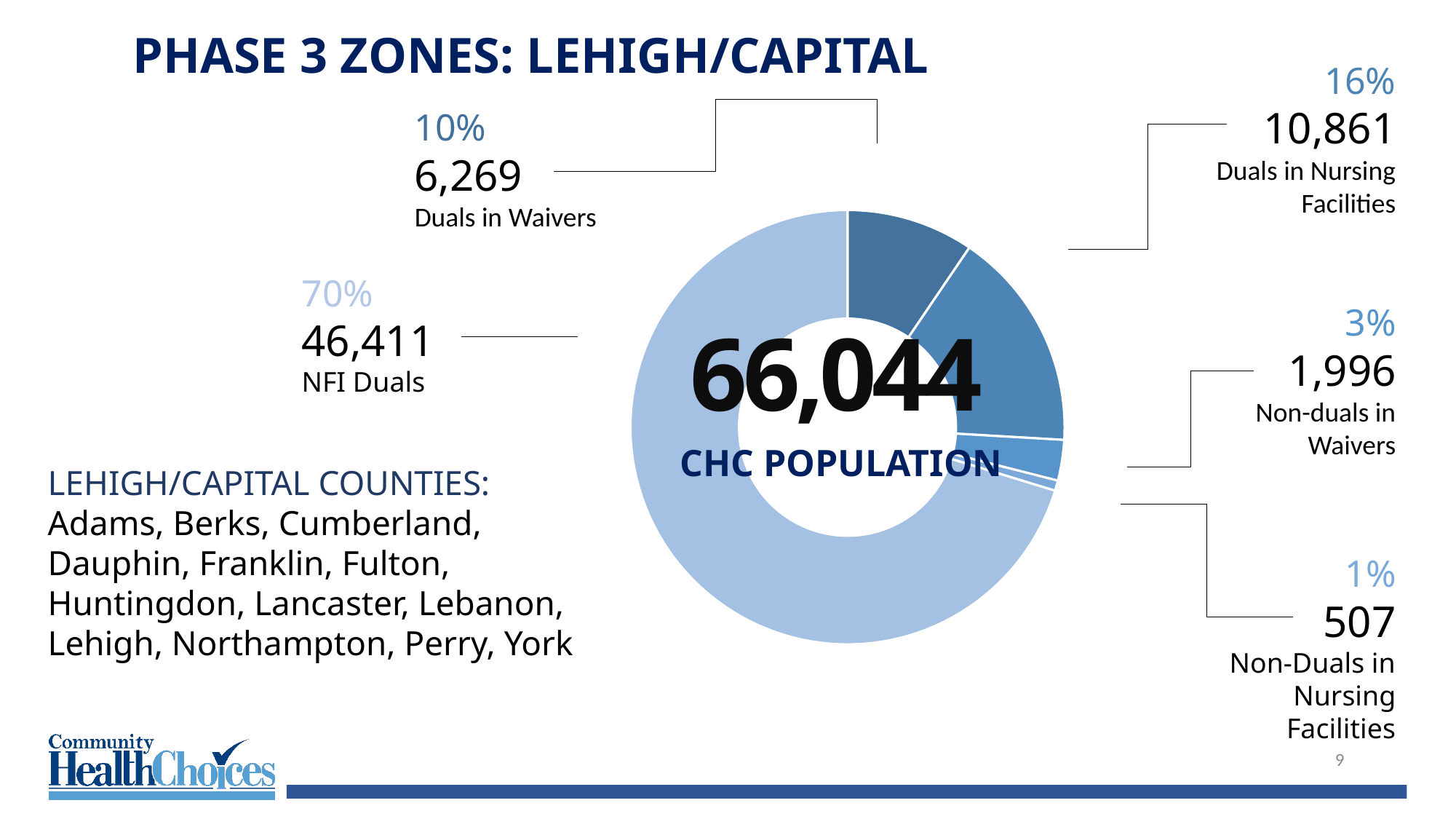
Which category has the largest share of the CHC population? NFI Duals Which category has the smallest share of the CHC population? Non-Duals in Nursing Facilities What percentage of the CHC population are Non-Duals in Nursing Facilities? 1% What is the value for Non-duals in Waivers? 1,996 What is the difference between the number of Duals in Nursing Facilities and the number of Duals in Waivers? 4,592 What kind of chart is shown on the slide? Donut (pie) chart How many NFI Duals are shown on the chart? 46,411 How many Duals in Waivers are shown on the chart? 6,269 What is the total CHC population shown in the centre of the chart? 66,044 Which is larger: Non-duals in Waivers or Non-Duals in Nursing Facilities? Non-duals in Waivers How many categories does the chart divide the CHC population into? 5 What percentage of the CHC population are Duals in Nursing Facilities? 16%